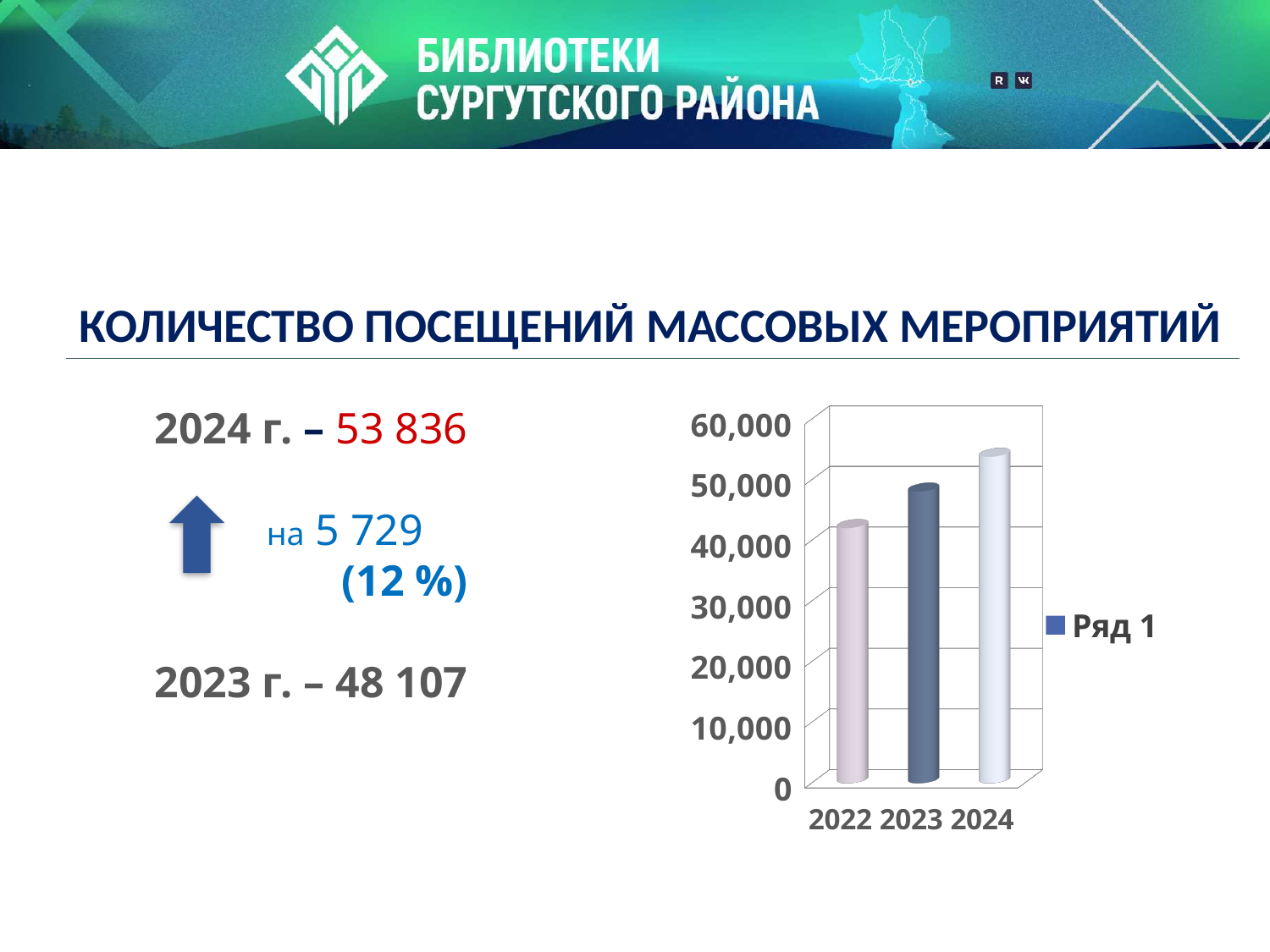
Is the value for 2022 greater or less than 40,000? greater Is the value for 2022 greater or less than 50,000? less Which year has the lowest bar in the chart? 2022 According to the slide, what is the number of visits to mass events in 2023? 48 107 How many series does the chart legend list? 1 By how much did the number of visits increase from 2023 to 2024? 5 729 Do the values rise or fall from 2022 to 2024 in the chart? rise According to the slide, what is the number of visits to mass events in 2024? 53 836 What is the name of the series in the chart legend? Ряд 1 How many categories (years) are shown on the x axis of the chart? 3 Which year has the highest bar in the chart? 2024 What kind of chart is shown on the slide? bar chart